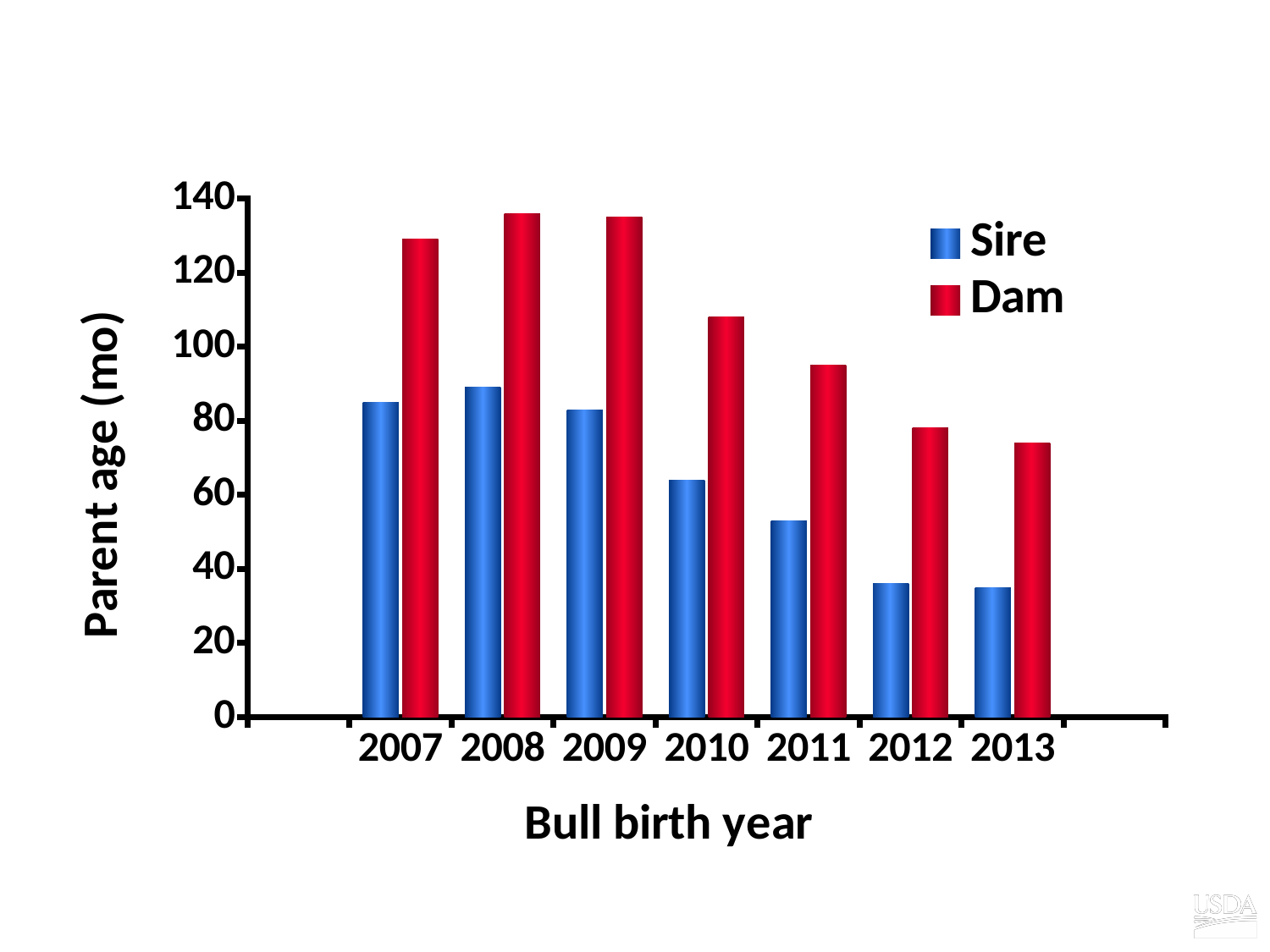
What kind of chart is shown on the slide? bar chart Is the Sire value for 2012 greater or less than 40? less Is the Sire value for 2011 greater or less than 60? less Which is larger, the Sire value for 2007 or the Sire value for 2011? 2007 Do the Dam values rise or fall from 2009 to 2013? fall How many bull birth years are shown on the x axis? 7 Is the Sire value for 2008 greater or less than 80? greater What is the label on the y axis? Parent age (mo) How many series does the legend list? 2 Which is larger in 2009, the Sire value or the Dam value? Dam